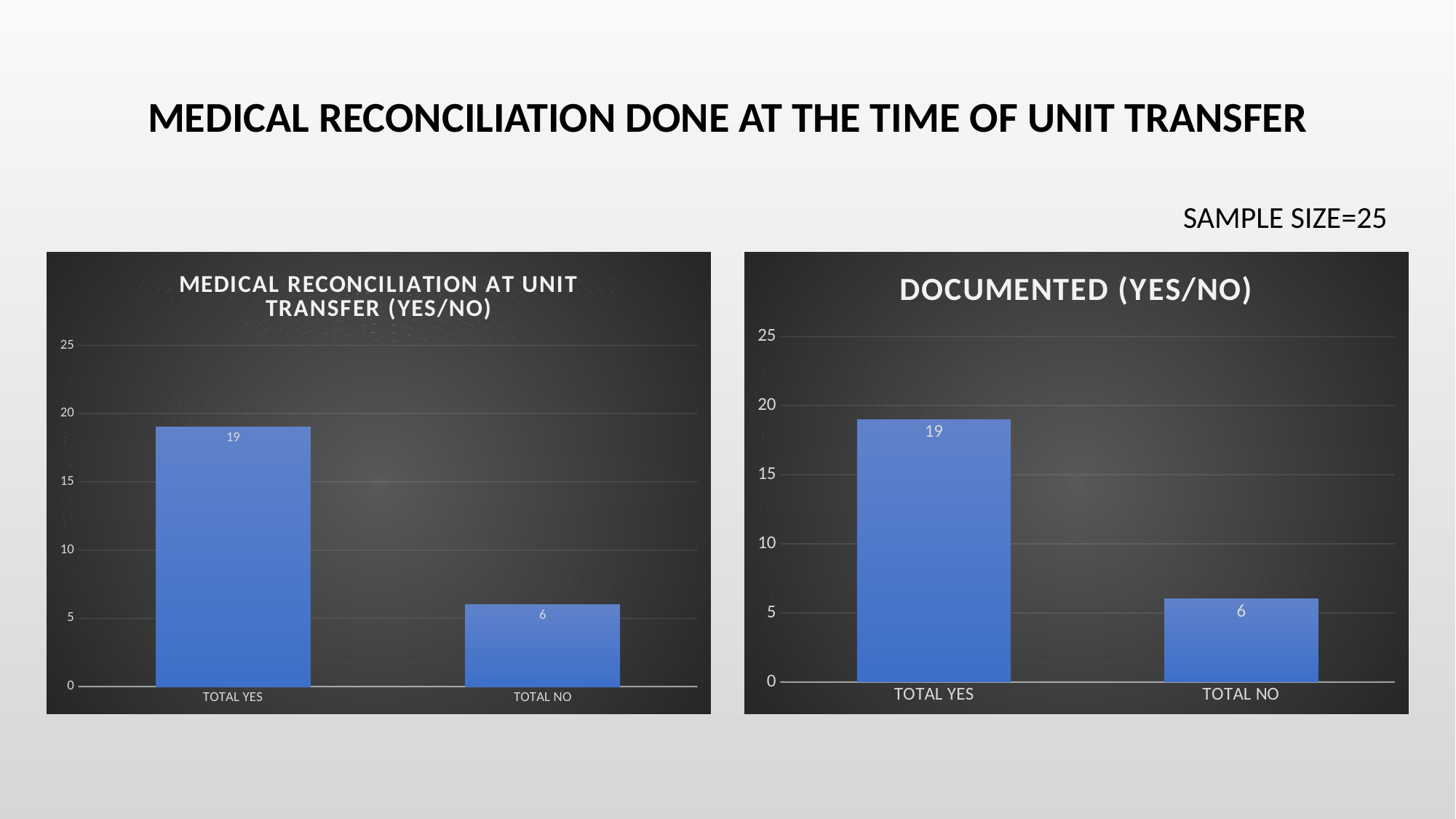
How many categories are shown in the chart titled "DOCUMENTED (YES/NO)"? 2 In the chart titled "DOCUMENTED (YES/NO)", what is the value for TOTAL NO? 6 What is the title of the right chart on the slide? DOCUMENTED (YES/NO) In the chart titled "DOCUMENTED (YES/NO)", what is the value for TOTAL YES? 19 What kind of chart is the left chart on the slide? bar chart In the left chart, which category has the highest value? TOTAL YES In the chart titled "DOCUMENTED (YES/NO)", what is the difference between TOTAL YES and TOTAL NO? 13 In the chart titled "MEDICAL RECONCILIATION AT UNIT TRANSFER (YES/NO)", what is the value for TOTAL YES? 19 In the right chart, which category has the lowest value? TOTAL NO In the right chart, is the value for TOTAL YES greater or less than 15? greater In the chart titled "MEDICAL RECONCILIATION AT UNIT TRANSFER (YES/NO)", what is the value for TOTAL NO? 6 In the left chart, which is larger, TOTAL YES or TOTAL NO? TOTAL YES